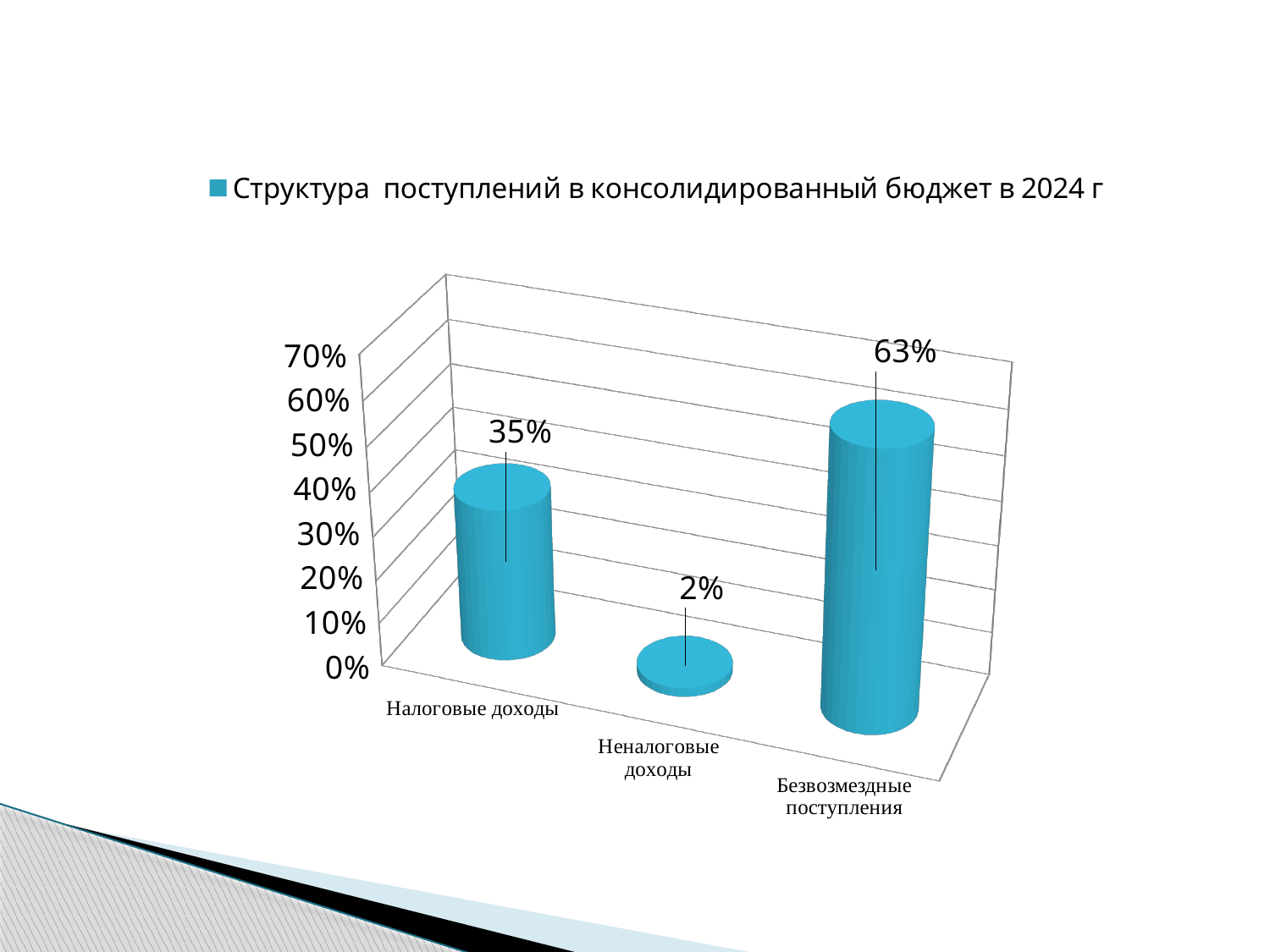
Is the value for Налоговые доходы greater or less than 50%? less What is the difference between the values for Налоговые доходы and Неналоговые доходы? 33% What is the legend entry shown above the chart? Структура поступлений в консолидированный бюджет в 2024 г What kind of chart is shown on the slide? bar chart What is the difference between the values for Безвозмездные поступления and Налоговые доходы? 28% What is the value for Неналоговые доходы? 2% Which category has the highest value? Безвозмездные поступления Which is larger, the value for Налоговые доходы or the value for Безвозмездные поступления? Безвозмездные поступления How many categories are shown on the chart? 3 Which category has the lowest value? Неналоговые доходы What is the value for Безвозмездные поступления? 63% What is the value for Налоговые доходы? 35%